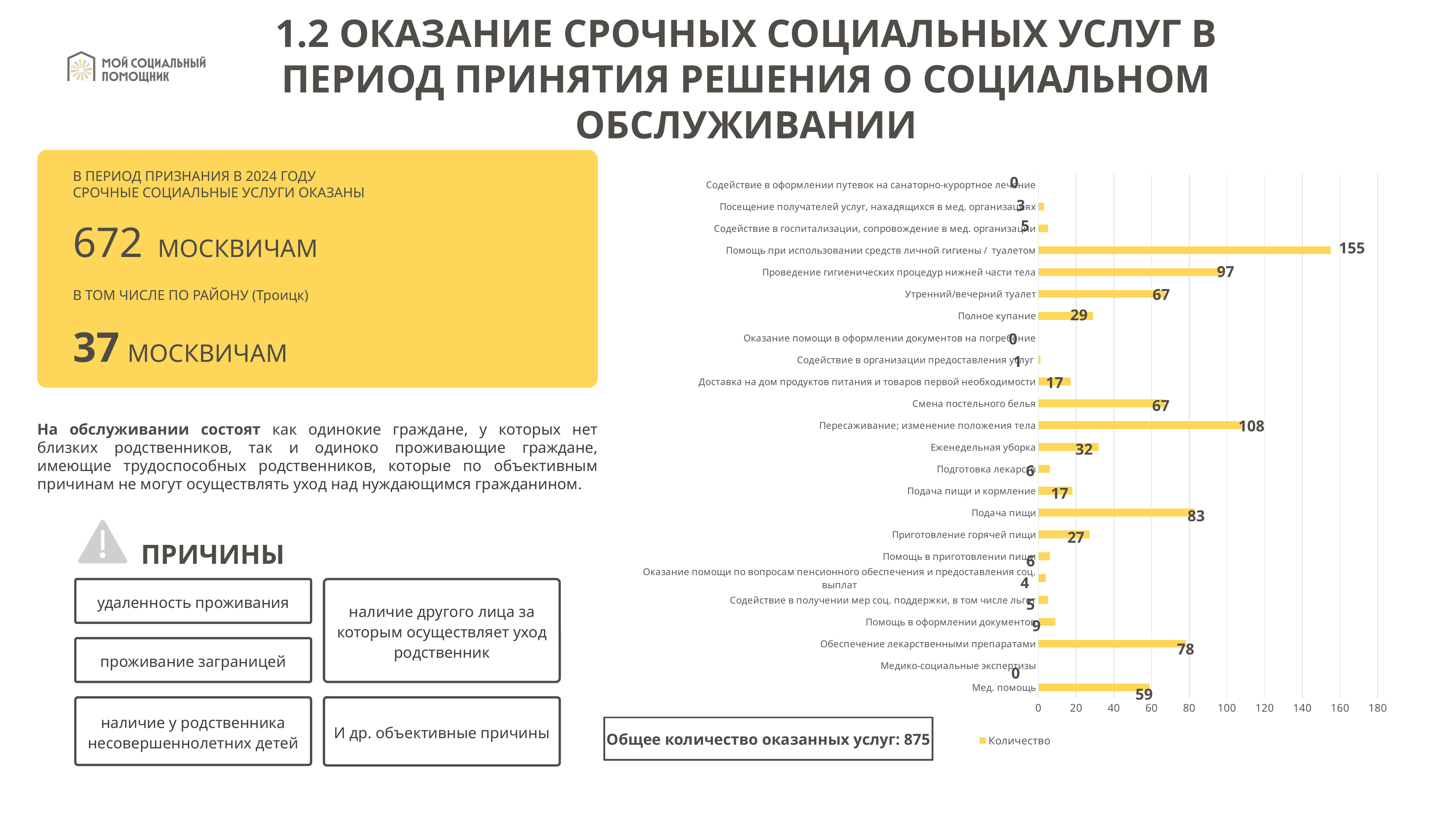
How many categories are plotted in the chart? 24 What is the difference between the values for "Проведение гигиенических процедур нижней части тела" and "Обеспечение лекарственными препаратами"? 19 What is the value for "Помощь при использовании средств личной гигиены / туалетом"? 155 Is the value for "Полное купание" greater or less than 40? less What type of chart is shown on the slide? bar chart What is the value for "Пересаживание; изменение положения тела"? 108 How many series does the legend list? 1 Which category has the highest value? Помощь при использовании средств личной гигиены / туалетом Which is larger: the value for "Подача пищи" or the value for "Утренний/вечерний туалет"? Подача пищи What is the value for "Еженедельная уборка"? 32 What is the legend entry of the chart? Количество What is the value for "Мед. помощь"? 59